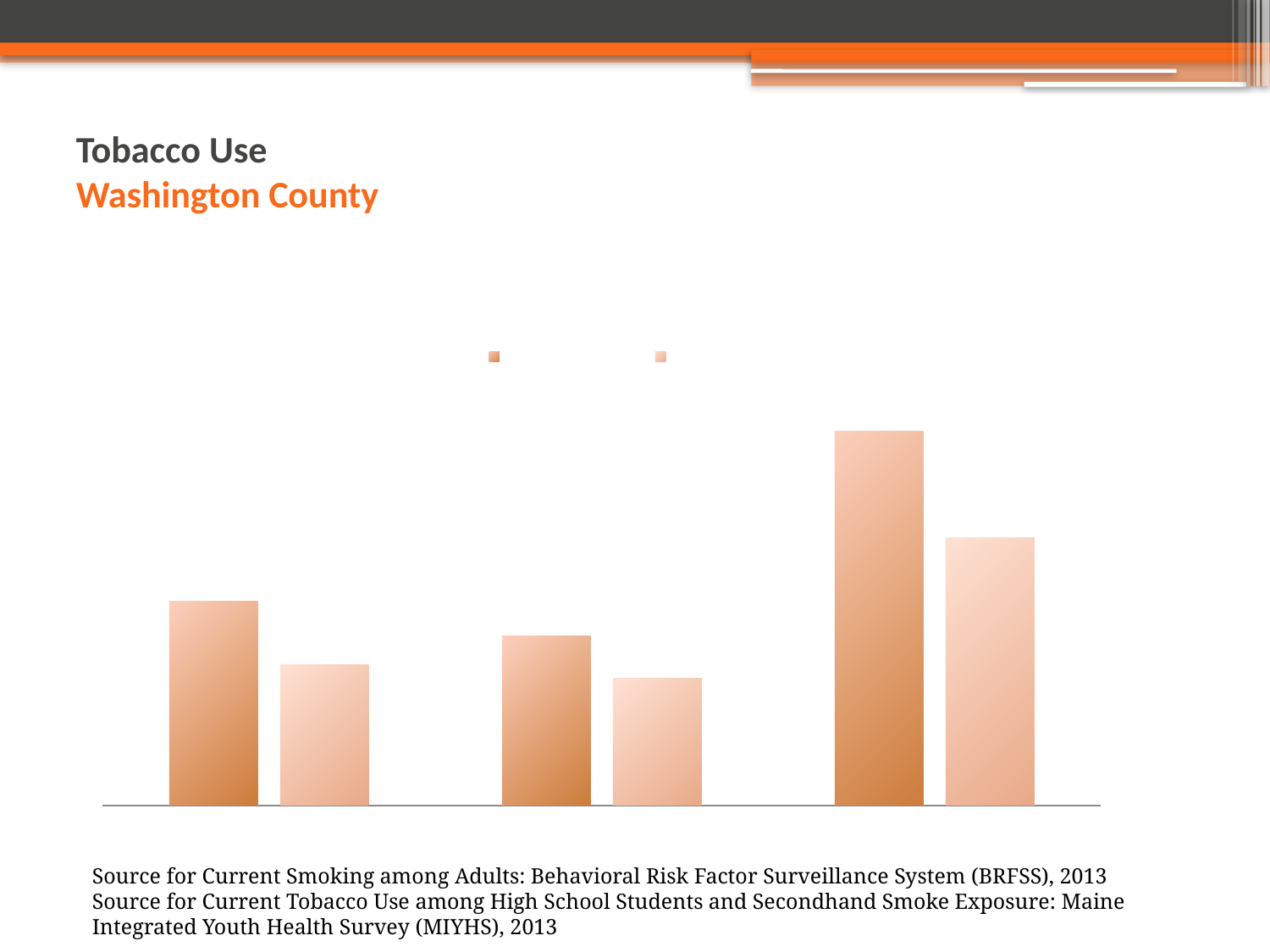
Which group of bars, counting from the left, has the shortest bars? the second (middle) group What kind of chart is shown on the slide? bar chart Where is the legend positioned relative to the bars? above the bars In the rightmost group, is the darker orange bar taller or shorter than the lighter bar? taller Is the darker orange bar taller than the lighter bar in every group? yes How many groups of bars are plotted on the chart? 3 How many bars are plotted on the chart in total? 6 Which group of bars, counting from the left, has the tallest bars? the third (rightmost) group Does the chart display data labels on its bars? no In the leftmost group, which bar is taller, the darker orange bar or the lighter bar? the darker orange bar How many series does the chart's legend list? 2